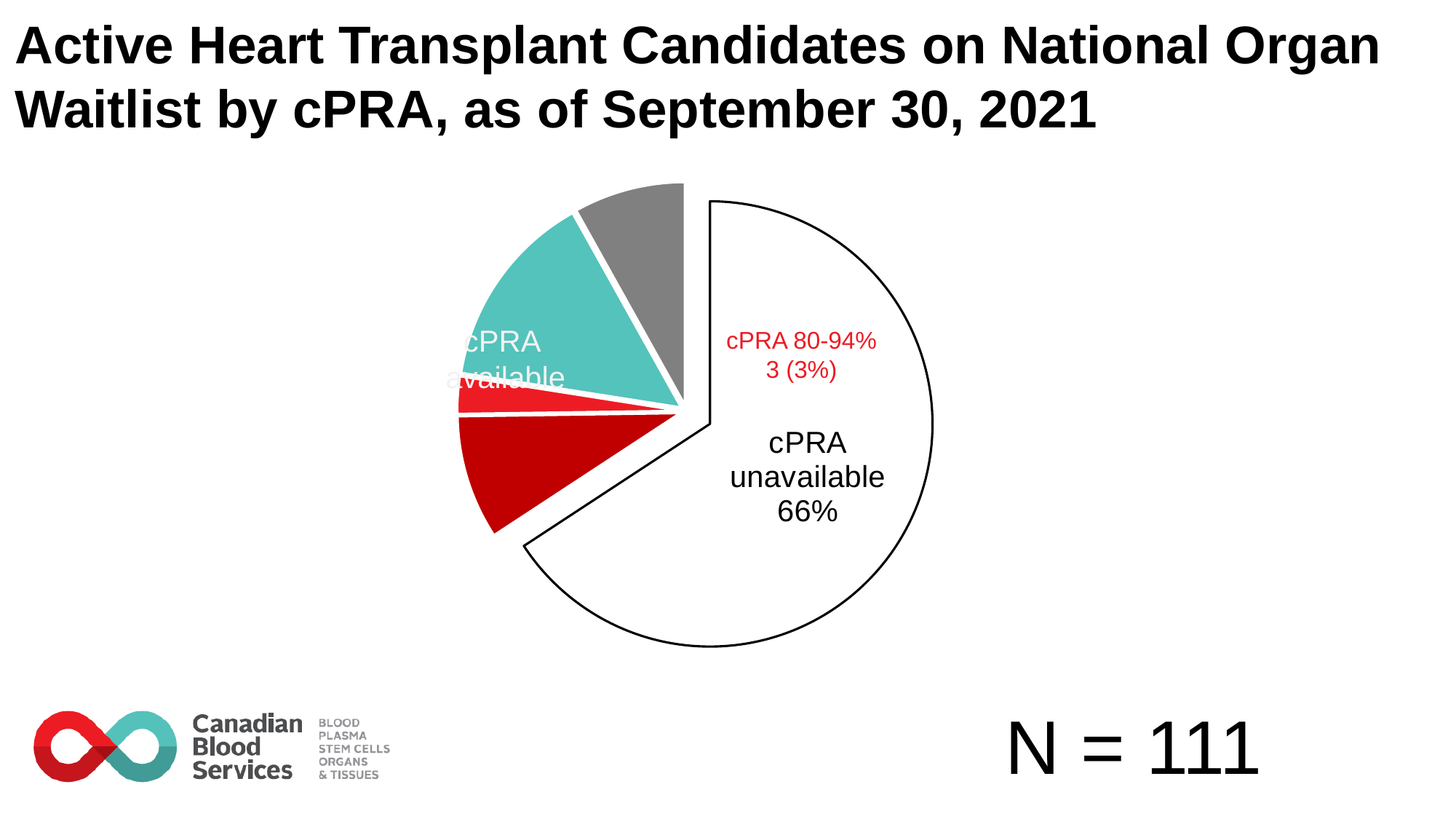
How many candidates are in the cPRA 80-94% group? 3 What is the total number of candidates (N) shown on the slide? N = 111 As of what date does the chart report active heart transplant candidates? September 30, 2021 Which is larger: the cPRA unavailable slice or the cPRA 80-94% slice? cPRA unavailable Is the cPRA unavailable share greater or less than 50%? greater What is the difference in percentage points between the cPRA unavailable share and the cPRA 80-94% share? 63 percentage points Which labelled slice of the pie is the smallest? cPRA 80-94% What percentage of active heart transplant candidates have cPRA unavailable? 66% What kind of chart is shown on the slide? pie chart What share of the pie does the cPRA 80-94% group represent? 3% Which slice of the pie is the largest? cPRA unavailable How many slices does the pie chart have? 5